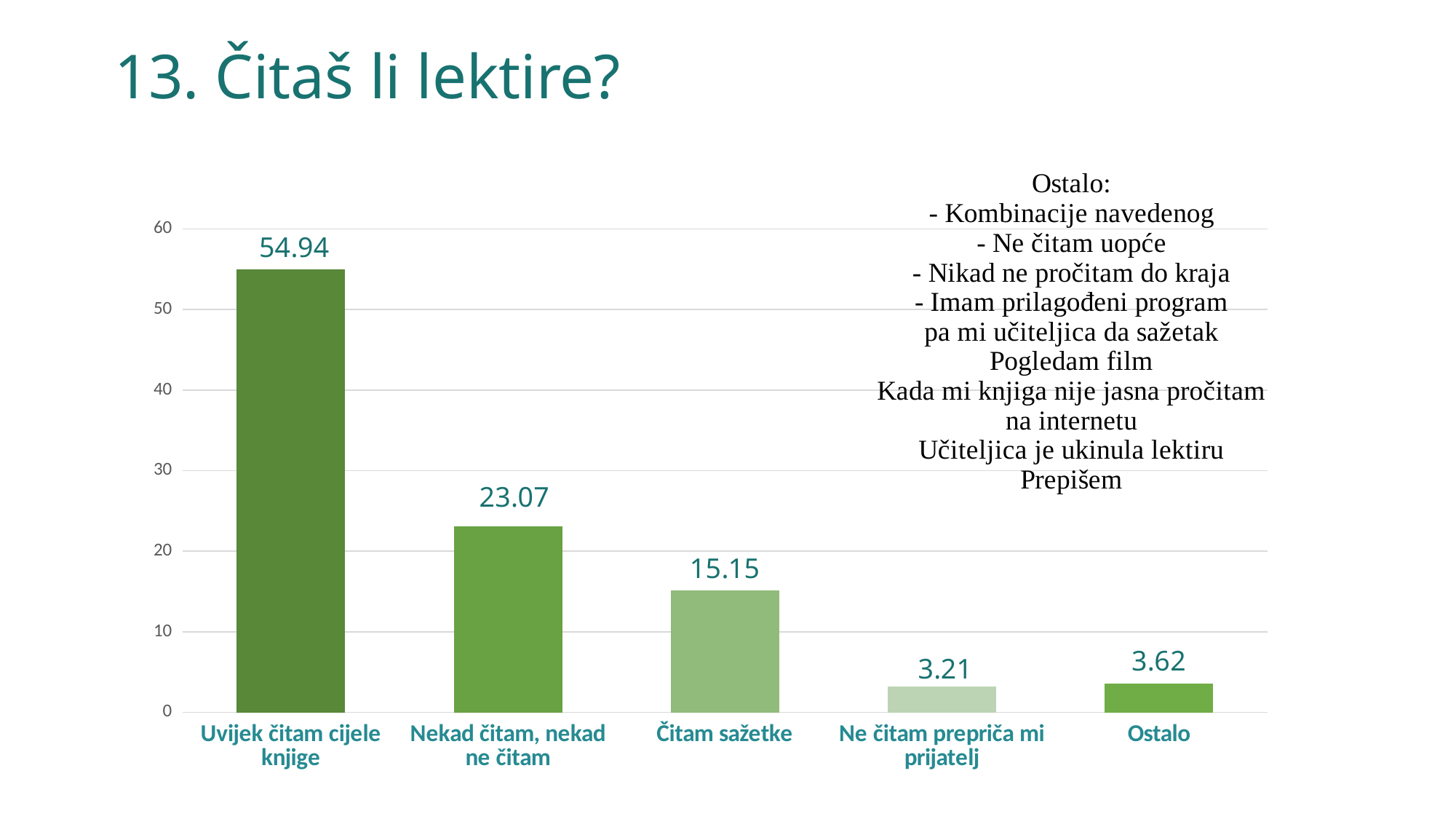
How many categories are shown in the chart? 5 What is the value for "Ne čitam prepriča mi prijatelj"? 3.21 Which category has the lowest value? Ne čitam prepriča mi prijatelj What kind of chart is shown on the slide? Bar chart Which is larger, the value for "Čitam sažetke" or the value for "Ostalo"? Čitam sažetke What is the value for "Ostalo"? 3.62 What is the value for "Čitam sažetke"? 15.15 What is the difference between the values for "Uvijek čitam cijele knjige" and "Nekad čitam, nekad ne čitam"? 31.87 Which category has the highest value? Uvijek čitam cijele knjige What is the value for "Nekad čitam, nekad ne čitam"? 23.07 What is the value for "Uvijek čitam cijele knjige"? 54.94 What is the title of the slide? 13. Čitaš li lektire?